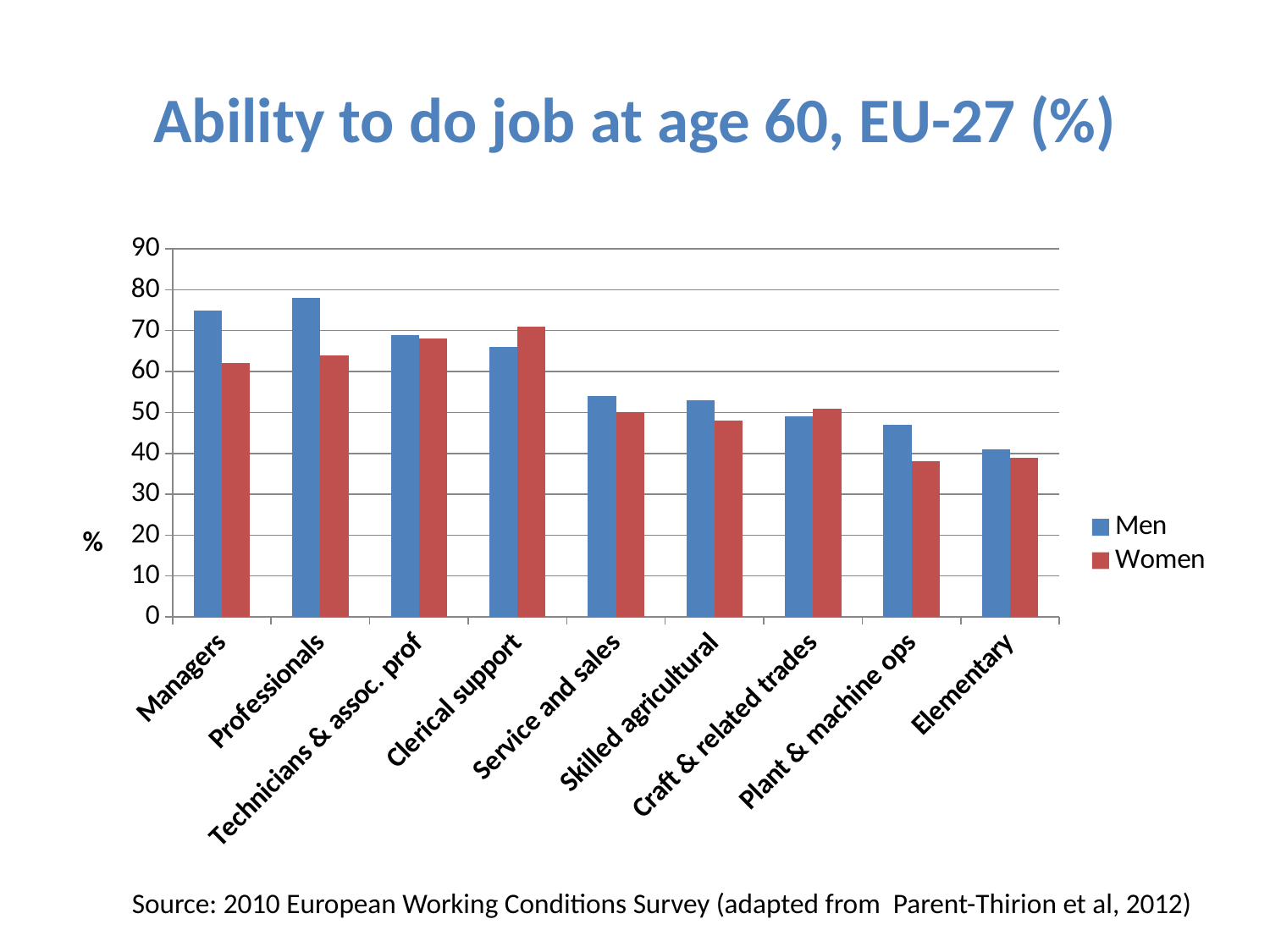
Which occupation has the highest value for Women? Clerical support Is the value for Men in Plant & machine ops greater or less than 50? less Is the value for Men in Managers greater or less than 70? greater How many series does the legend list? 2 For Managers, which is larger, the value for Men or for Women? Men How many occupation categories are shown on the x axis? 9 For Clerical support, which is larger, the value for Men or for Women? Women Do the values for Men generally rise or fall from left to right across the occupations? fall Which occupation has the lowest value for Men? Elementary Which occupation has the highest value for Men? Professionals Is the value for Women in Plant & machine ops greater or less than 40? less What kind of chart is shown on the slide? bar chart